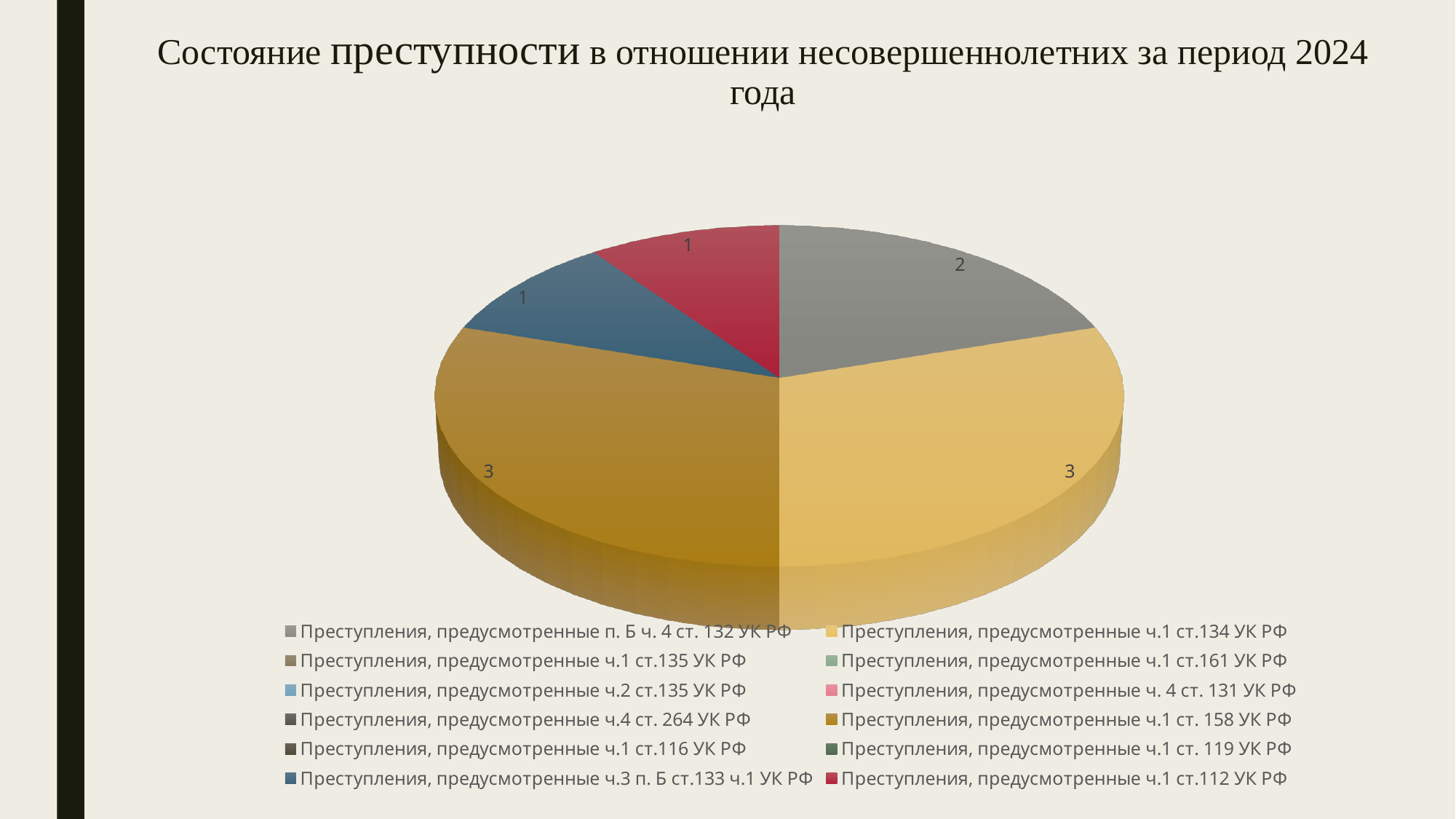
How many entries does the legend list? 12 What is the value of the slice for «Преступления, предусмотренные п. Б ч. 4 ст. 132 УК РФ»? 2 How many slices with data labels are visible in the pie? 5 Which is larger: the value for «п. Б ч. 4 ст. 132 УК РФ» or the value for «ч.1 ст.134 УК РФ»? ч.1 ст.134 УК РФ What is the title of the chart? Состояние преступности в отношении несовершеннолетних за период 2024 года What type of chart is shown on the slide? Pie chart What is the value of the slice for «Преступления, предусмотренные ч.1 ст.112 УК РФ»? 1 What is the difference between the value for «ч.1 ст. 158 УК РФ» and the value for «ч.1 ст.112 УК РФ»? 2 What is the value of the slice for «Преступления, предусмотренные ч.1 ст. 158 УК РФ»? 3 What is the value of the slice for «Преступления, предусмотренные ч.3 п. Б ст.133 ч.1 УК РФ»? 1 Which legend entry does the red slice correspond to? Преступления, предусмотренные ч.1 ст.112 УК РФ What is the value of the slice for «Преступления, предусмотренные ч.1 ст.134 УК РФ»? 3